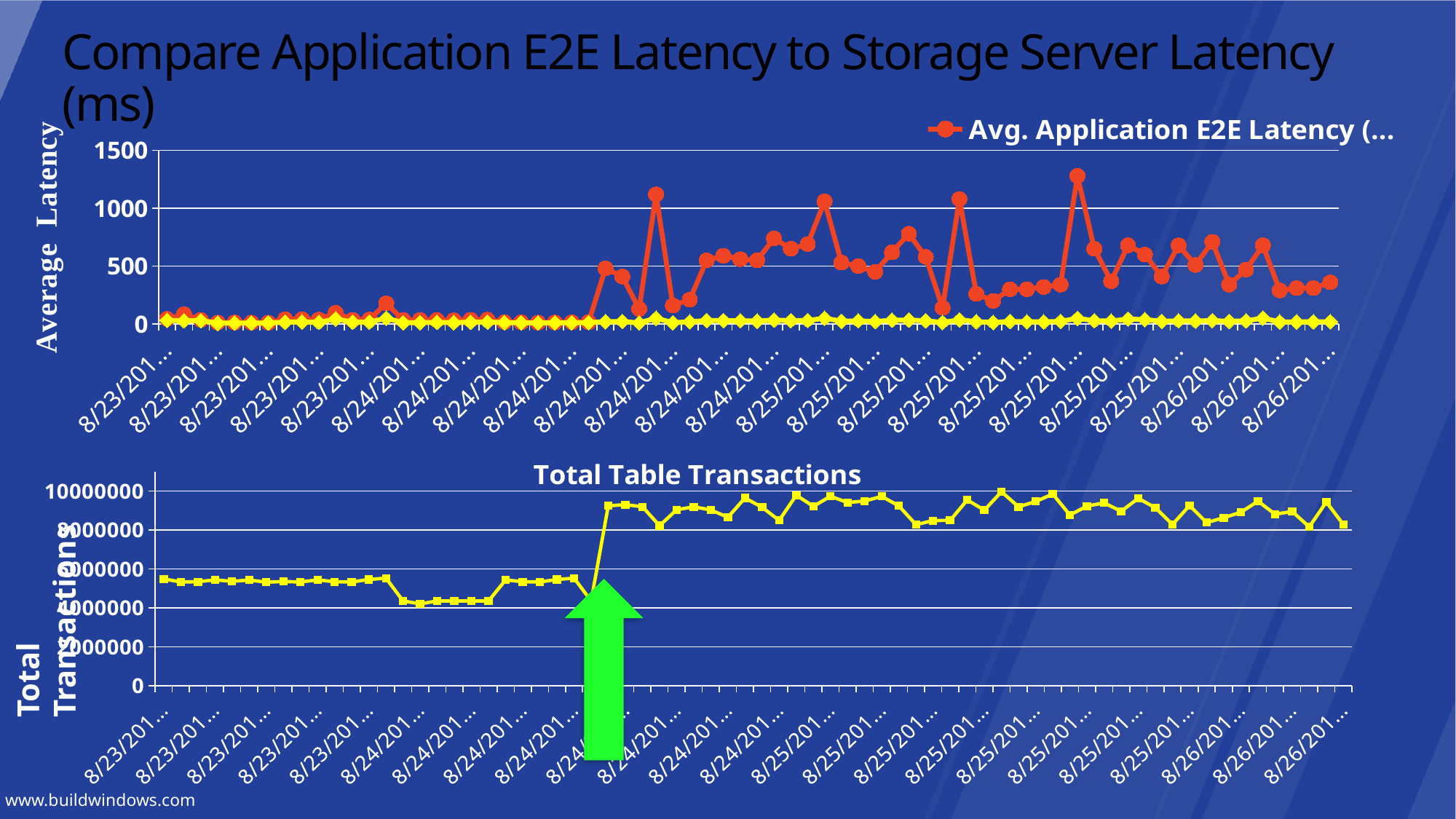
What is the title of the bottom chart? Total Table Transactions In the bottom chart, are the Total Table Transactions values at the start of the series (8/23) greater or less than 6000000? less In the top chart, is the highest value of the red Avg. Application E2E Latency series greater or less than 1000? greater In the bottom chart, do the Total Table Transactions values overall rise or fall from left to right along the x axis? rise In the top chart, does the red Avg. Application E2E Latency series overall rise or fall from the 8/23 points to the 8/25 points? rise How many data series are plotted in the top chart? 2 What kind of chart is the top chart on the slide? line chart What is the highest value shown on the y axis of the bottom chart? 10000000 In the top chart, are the values of the yellow series greater or less than 500 throughout? less In the top chart, what colour is the line for Avg. Application E2E Latency? red What kind of chart is the bottom chart titled "Total Table Transactions"? line chart